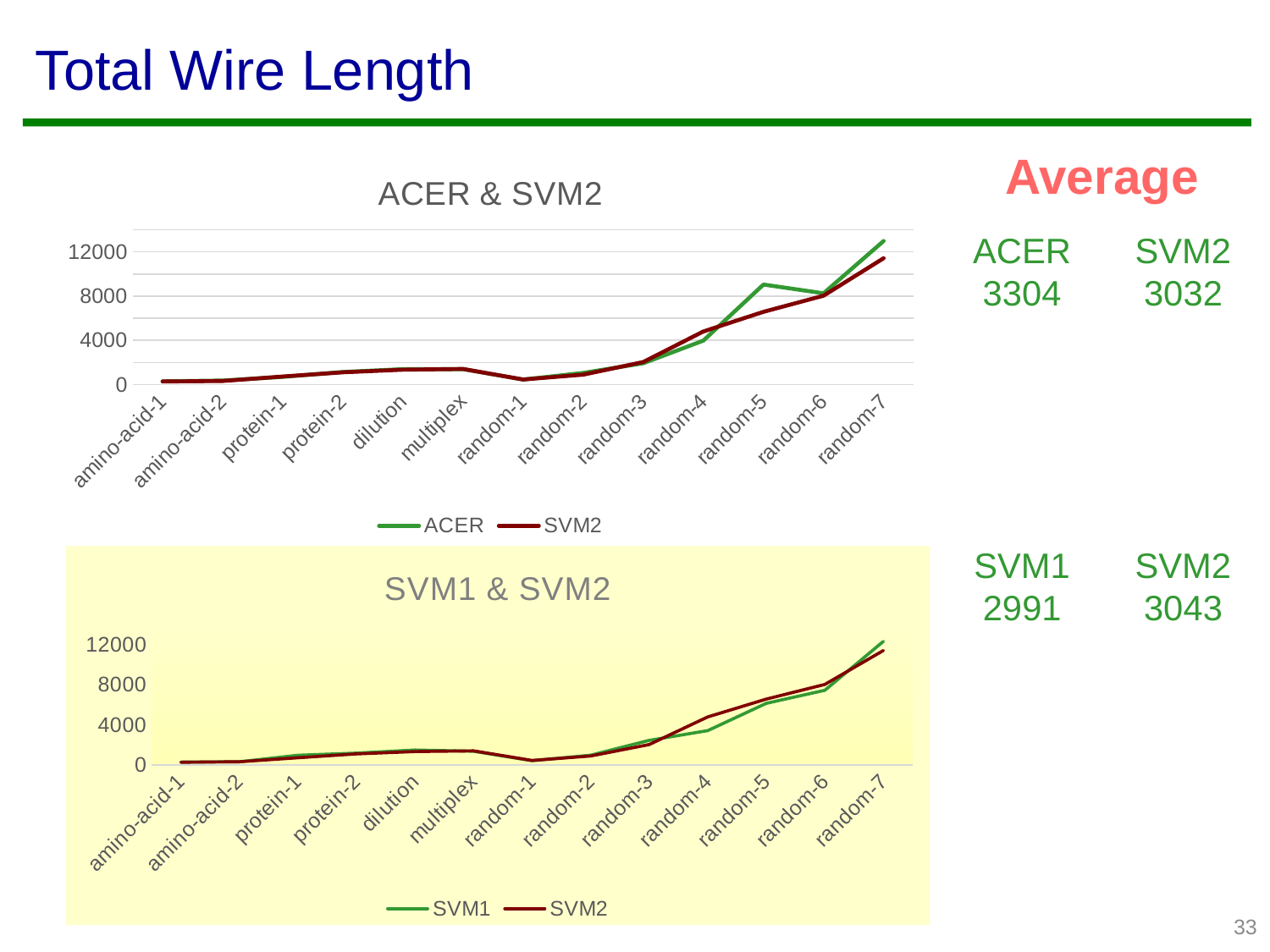
In the "ACER & SVM2" chart, is the ACER value for random-7 greater or less than 12000? greater What are the two series named in the legend of the bottom chart? SVM1 and SVM2 How many series does the legend of the "ACER & SVM2" chart list? 2 In the "ACER & SVM2" chart, which category has the highest ACER value? random-7 In the "ACER & SVM2" chart, which series has the larger value at random-5, ACER or SVM2? ACER In the "ACER & SVM2" chart, is the ACER value for random-5 greater or less than 8000? greater In the "SVM1 & SVM2" chart, which category has the highest SVM2 value? random-7 What kind of chart is the "ACER & SVM2" chart? line chart In the "SVM1 & SVM2" chart, is the SVM1 value for random-5 greater or less than 4000? greater In the "SVM1 & SVM2" chart, do the values generally rise or fall from amino-acid-1 to random-7? rise How many categories are plotted along the x axis of the "SVM1 & SVM2" chart? 13